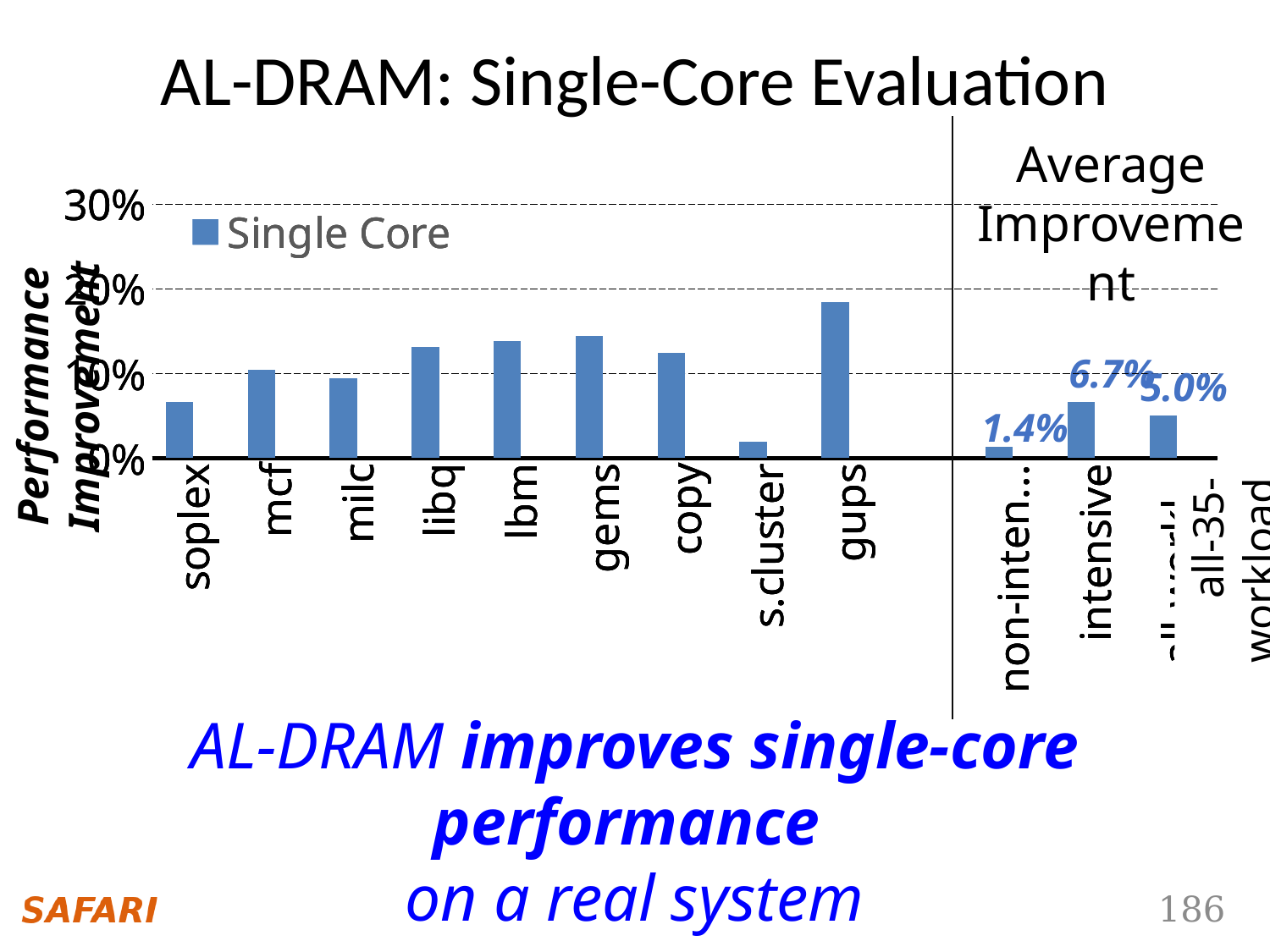
Among the three average-improvement bars, which is the lowest? non-intensive Which benchmark has the highest single-core performance improvement? gups How many series does the legend list? 1 What is the difference between the average improvement for intensive and non-intensive workloads? 5.3% What is the average performance improvement for the intensive workloads? 6.7% What is the average performance improvement for the all-35-workload category? 5.0% Is the performance improvement for gups greater or less than 10%? greater What is the average performance improvement for the non-intensive workloads? 1.4% What kind of chart is shown on the slide? bar chart Which has a larger performance improvement, gups or soplex? gups How many categories are shown on the x axis of the chart? 12 Is the performance improvement for s.cluster greater or less than 10%? less